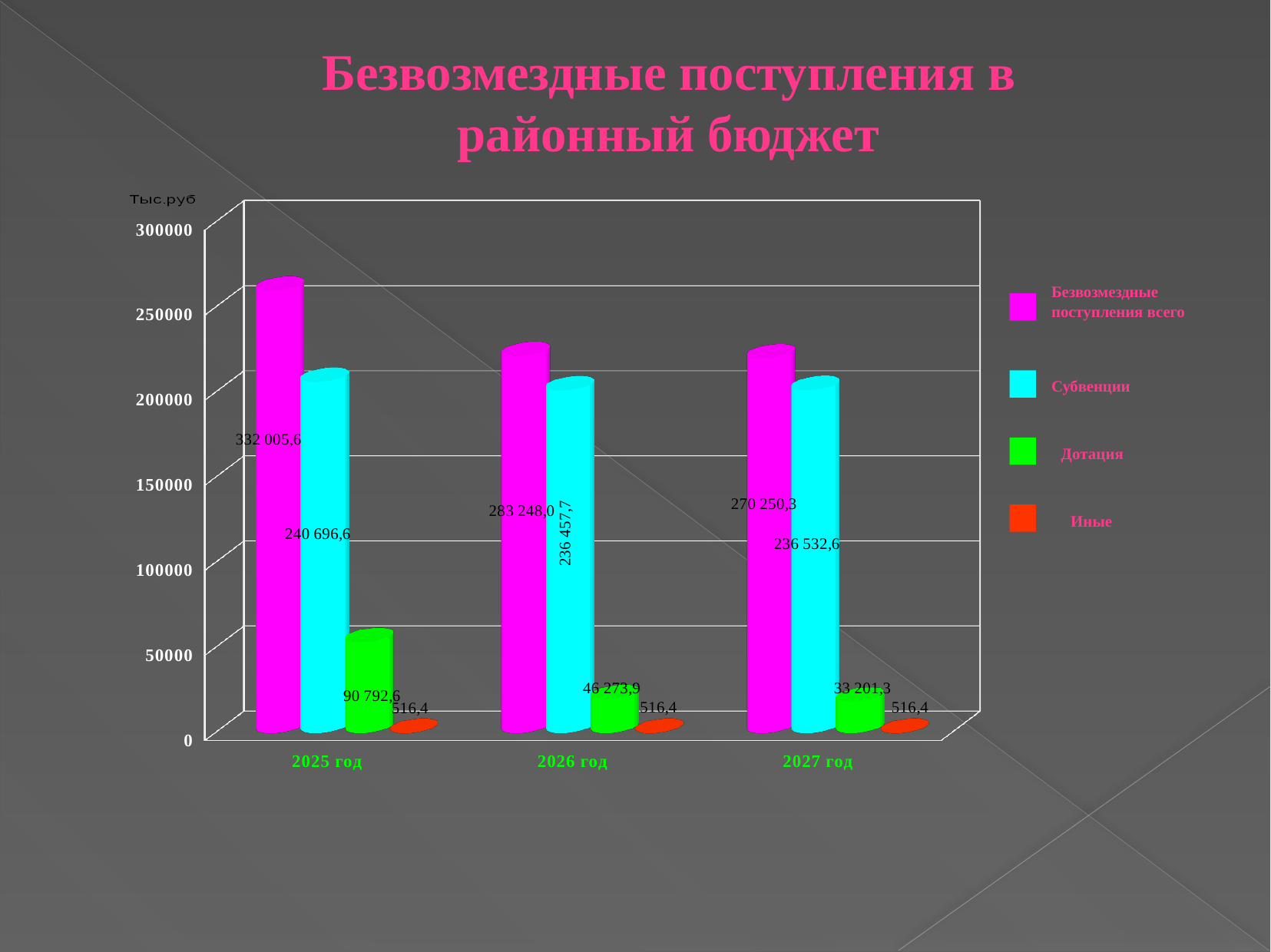
Does Безвозмездные поступления всего rise or fall from 2025 год to 2027 год? fall In which year is Безвозмездные поступления всего the highest? 2025 год What is the difference between Дотация in 2025 год and in 2026 год? 44 518,7 What is the value of Безвозмездные поступления всего for 2025 год? 332 005,6 What is the difference between Безвозмездные поступления всего in 2025 год and in 2026 год? 48 757,6 What is the value of Иные for 2025 год? 516,4 What is the value of Дотация for 2027 год? 33 201,3 In which year is Дотация the lowest? 2027 год How many years are shown on the x axis? 3 Which is larger: Субвенции in 2026 год or in 2027 год? 2027 год How many series does the legend list? 4 What is the value of Субвенции for 2026 год? 236 457,7